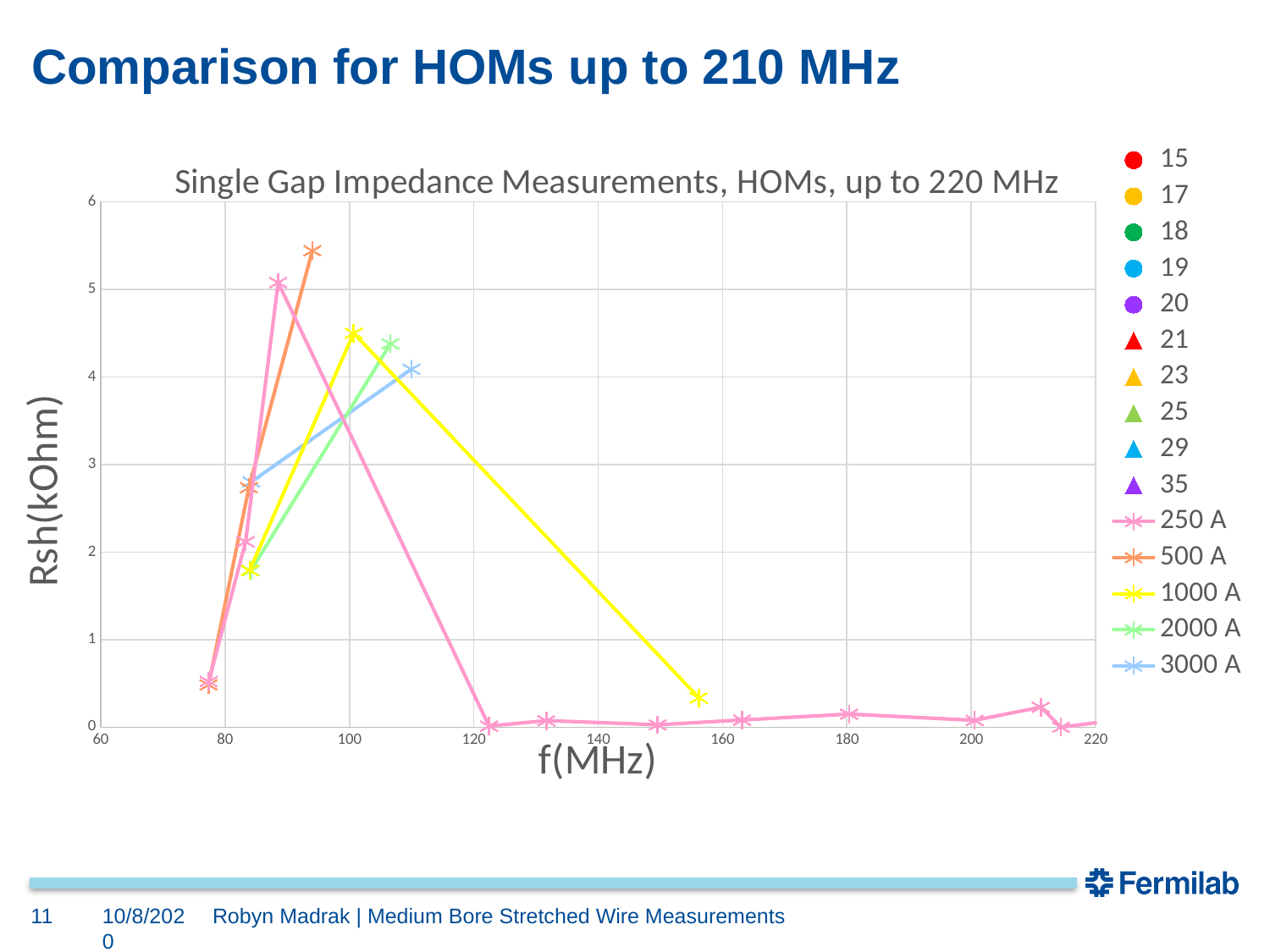
What is the label of the y axis? Rsh(kOhm) How many series does the legend list? 15 Which series has the larger peak value, 500 A or 1000 A? 500 A Is the peak value of the 2000 A series greater or less than 4? greater For the 250 A series, do the values rise or fall between about 88 MHz and 122 MHz? fall Is the peak value of the 500 A series greater or less than 5? greater Is the peak value of the 1000 A series greater or less than 4? greater What kind of chart is shown on the slide? line chart What is the title of the chart? Single Gap Impedance Measurements, HOMs, up to 220 MHz Which series reaches the highest Rsh value on the chart? 500 A